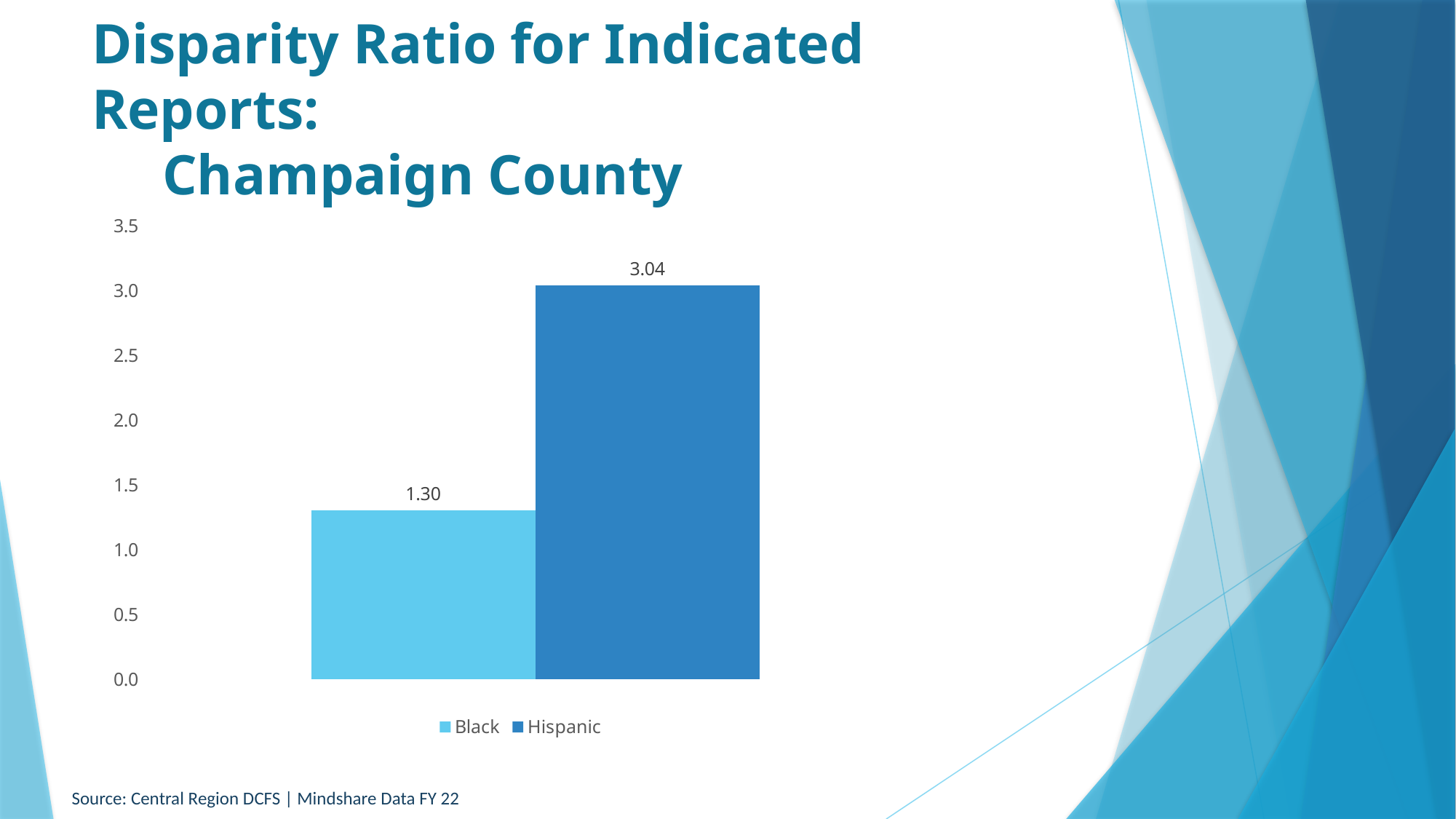
What is the disparity ratio for Hispanic? 3.04 Which series has the highest disparity ratio? Hispanic Is the disparity ratio for Black greater or less than 1.5? less What is the maximum value shown on the vertical axis? 3.5 Which is larger, the disparity ratio for Black or for Hispanic? Hispanic Is the disparity ratio for Hispanic greater or less than 3.0? greater What is the difference between the Hispanic and Black disparity ratios? 1.74 How many bars are plotted in the chart? 2 Which series has the lowest disparity ratio? Black What is the disparity ratio for Black? 1.30 How many series does the legend list? 2 What kind of chart is shown on the slide? Bar chart